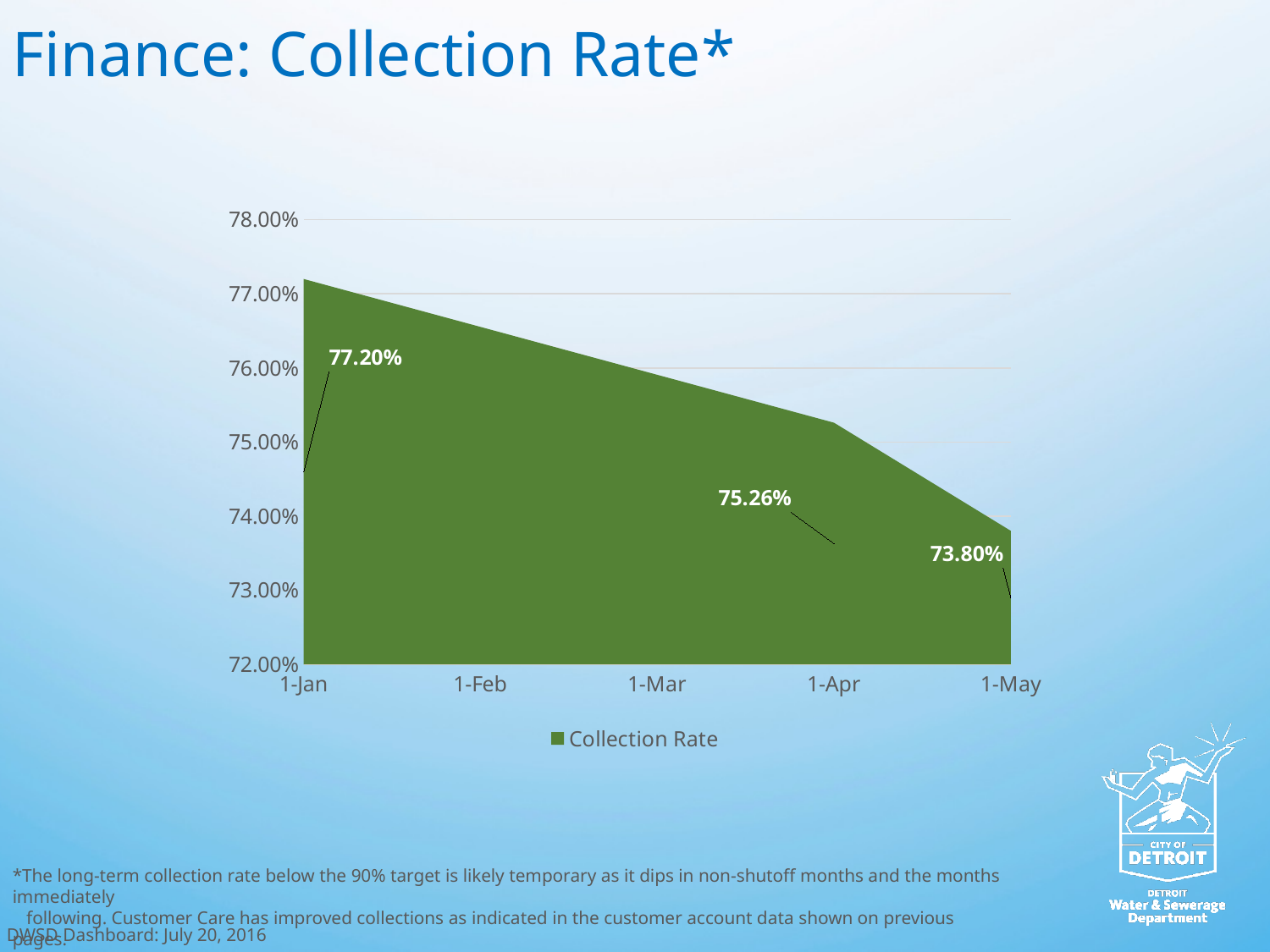
Does the collection rate rise or fall from 1-Jan to 1-May? Fall What is the collection rate on 1-May? 73.80% Which date has the highest collection rate? 1-Jan What is the difference between the collection rate on 1-Jan and on 1-May? 3.40% Which date has the lowest collection rate? 1-May What kind of chart is shown on the slide? Area chart Which is larger, the collection rate on 1-Jan or on 1-Apr? 1-Jan What is the collection rate on 1-Jan? 77.20% How many dates are shown on the x axis? 5 What is the difference between the collection rate on 1-Apr and on 1-May? 1.46% What is the collection rate on 1-Apr? 75.26%